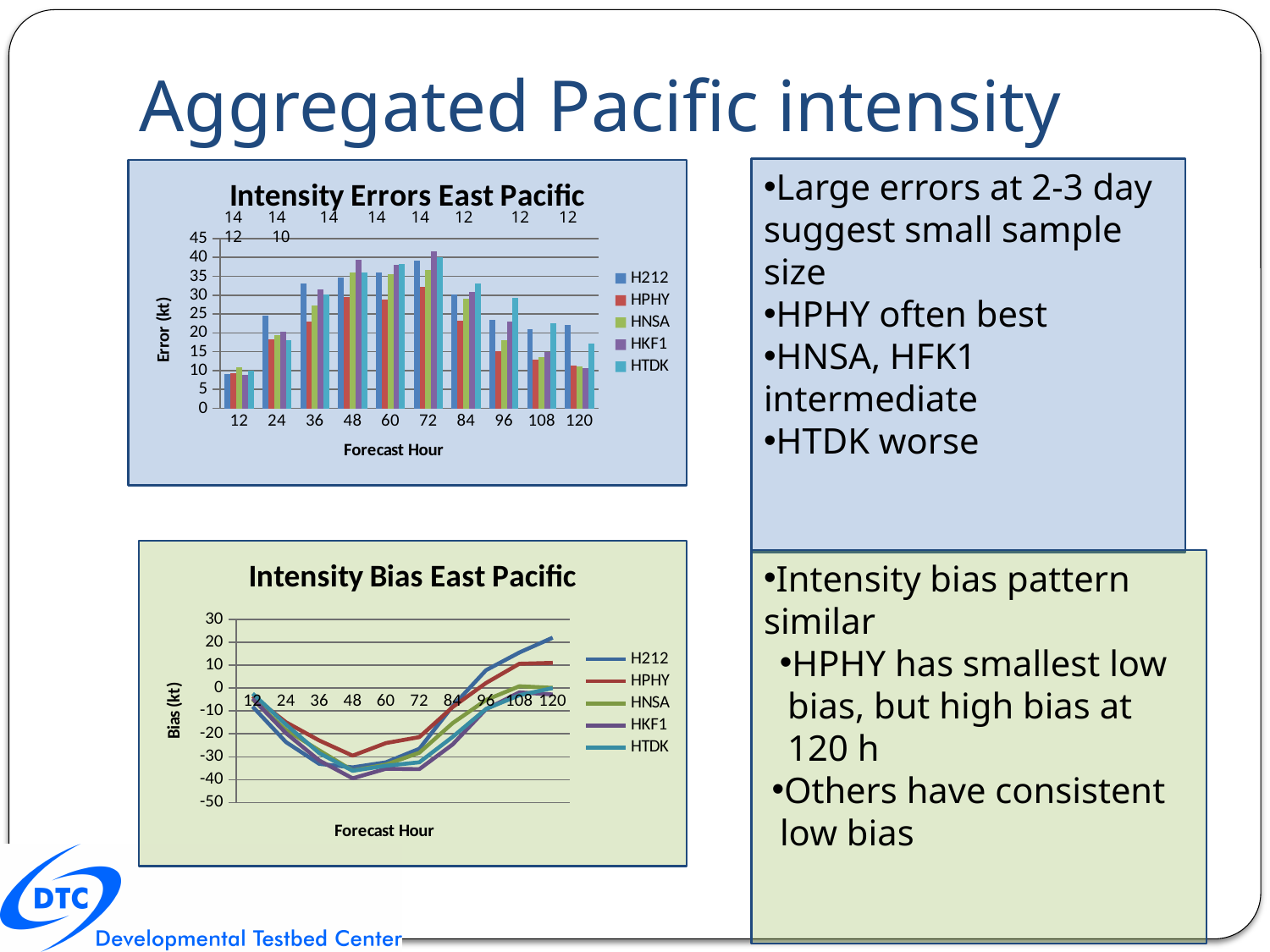
In the "Intensity Errors East Pacific" chart, is the value for HPHY at forecast hour 72 greater or less than 40? less In the "Intensity Errors East Pacific" chart, is the value for HKF1 at forecast hour 48 greater or less than 35? greater What kind of chart is the "Intensity Bias East Pacific" chart? line chart In the "Intensity Bias East Pacific" chart, which series has the highest bias at forecast hour 120? H212 What kind of chart is the "Intensity Errors East Pacific" chart? bar chart How many series does the legend of the "Intensity Errors East Pacific" chart list? 5 In the "Intensity Errors East Pacific" chart, which is larger at forecast hour 120, HTDK or HPHY? HTDK In the "Intensity Bias East Pacific" chart, which series has the lowest bias at forecast hour 48? HKF1 How many forecast hours are shown on the x axis of the "Intensity Bias East Pacific" chart? 10 In the "Intensity Errors East Pacific" chart, does the HTDK error rise or fall from forecast hour 72 to 120? fall In the "Intensity Bias East Pacific" chart, is the value for HKF1 at forecast hour 48 greater or less than -30? less What is the label of the y axis of the "Intensity Bias East Pacific" chart? Bias (kt)